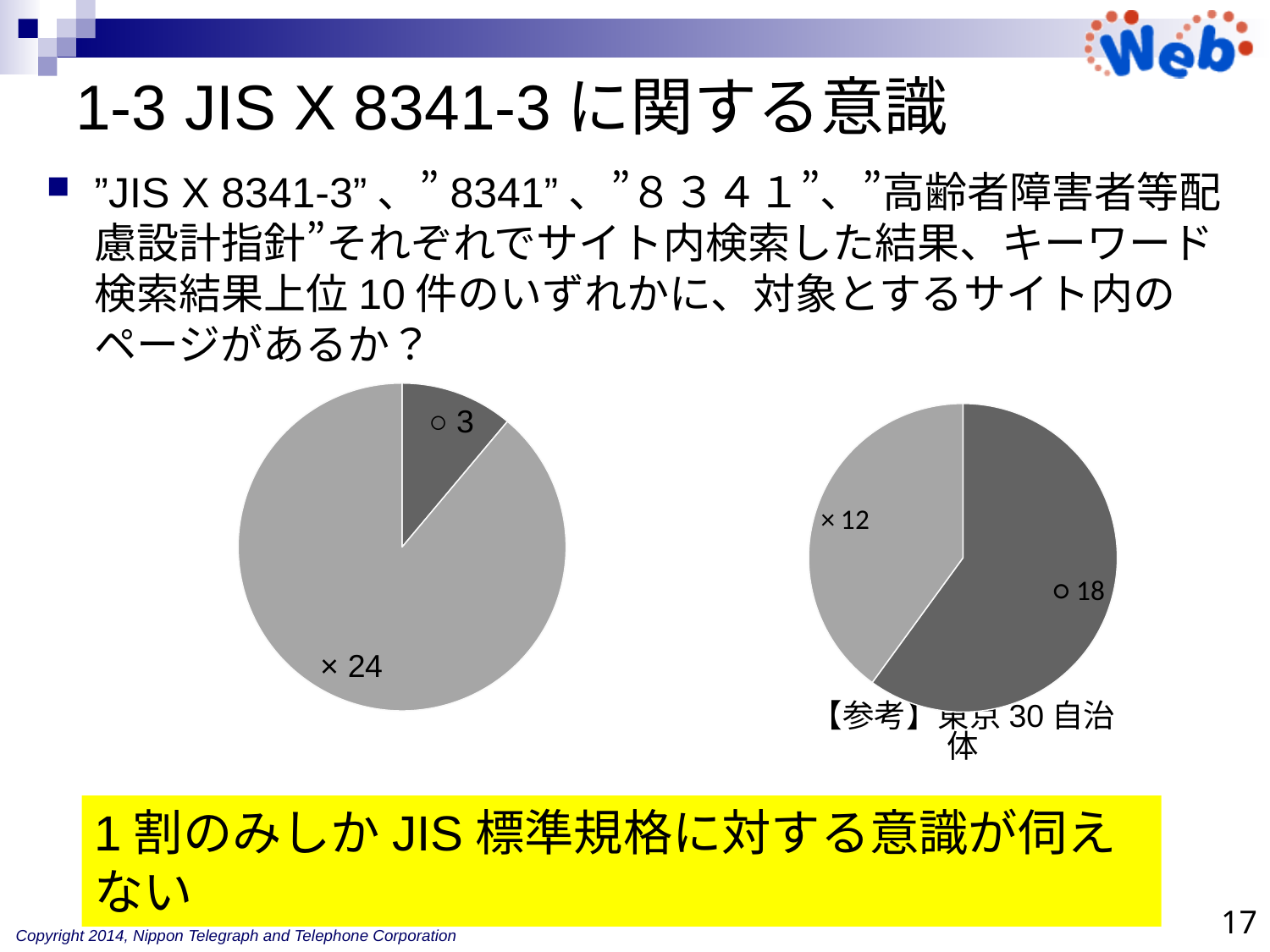
In the right pie chart (【参考】東京30自治体), which slice is the largest? ○ In the right pie chart (【参考】東京30自治体), what is the difference between the ○ value and the × value? 6 In the left pie chart, which slice is larger, ○ or ×? × In the right pie chart (【参考】東京30自治体), what is the value for ○? 18 In the right pie chart (【参考】東京30自治体), what share of the total does the ○ slice represent? 60% In the left pie chart, what is the value for ×? 24 What kind of chart is the chart on the right of the slide? pie chart In the left pie chart, what is the value for ○? 3 How many charts are shown on the slide? 2 In the left pie chart, what is the difference between the × value and the ○ value? 21 How many slices does the left pie chart have? 2 In the right pie chart (【参考】東京30自治体), what is the value for ×? 12